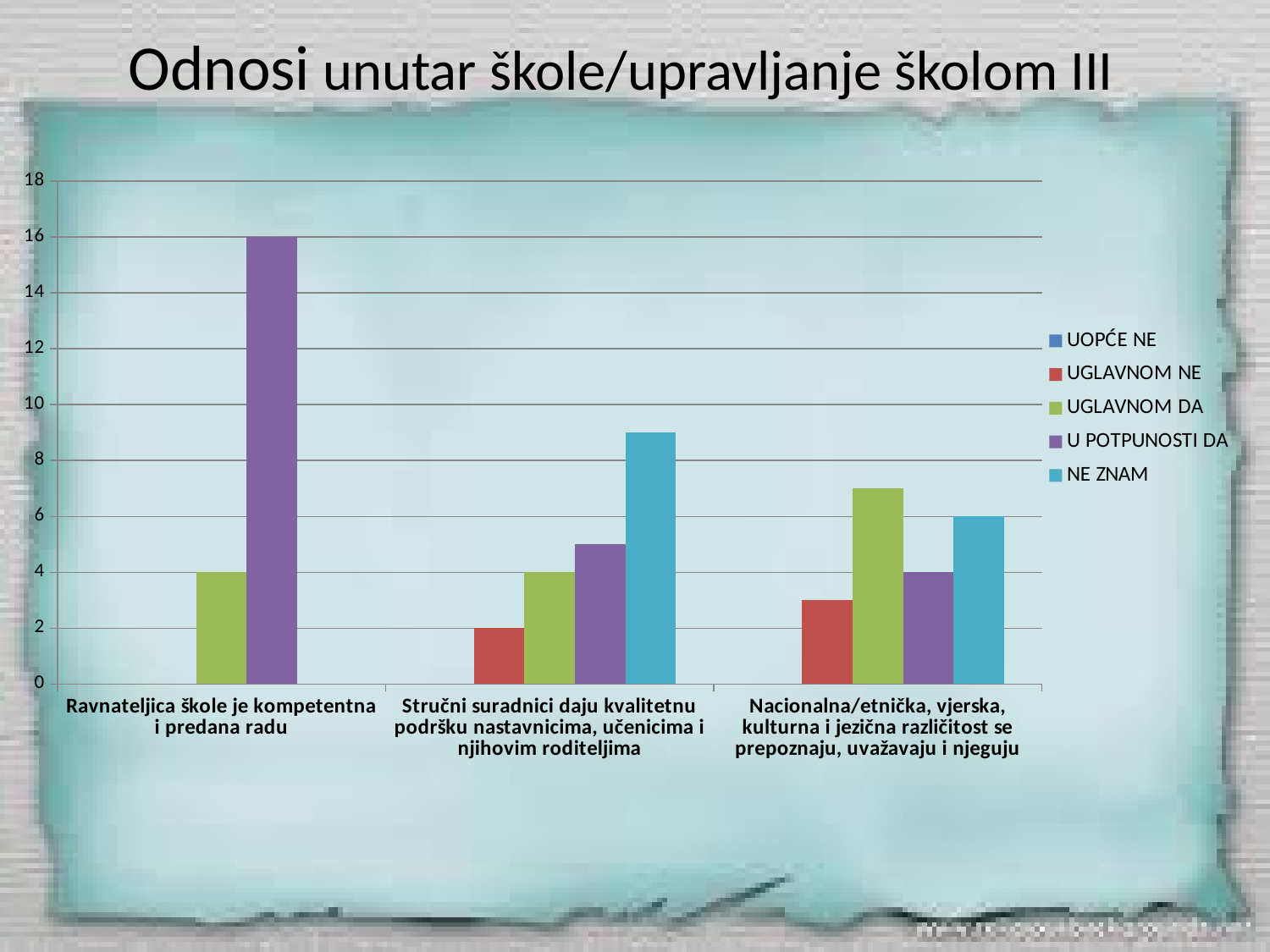
How many series does the legend list? 5 What is the value of U POTPUNOSTI DA for 'Ravnateljica škole je kompetentna i predana radu'? 16 What is the difference between the U POTPUNOSTI DA and UGLAVNOM DA values for 'Ravnateljica škole je kompetentna i predana radu'? 12 Is the value of UGLAVNOM DA for 'Nacionalna/etnička, vjerska, kulturna i jezična različitost se prepoznaju, uvažavaju i njeguju' greater or less than 8? less What is the value of UGLAVNOM NE for 'Stručni suradnici daju kvalitetnu podršku nastavnicima, učenicima i njihovim roditeljima'? 2 Which series has the highest value for 'Stručni suradnici daju kvalitetnu podršku nastavnicima, učenicima i njihovim roditeljima'? NE ZNAM What kind of chart is shown on the slide? bar chart What is the value of NE ZNAM for 'Nacionalna/etnička, vjerska, kulturna i jezična različitost se prepoznaju, uvažavaju i njeguju'? 6 What is the value of UGLAVNOM DA for 'Ravnateljica škole je kompetentna i predana radu'? 4 Which series has the highest value for 'Ravnateljica škole je kompetentna i predana radu'? U POTPUNOSTI DA How many categories are shown on the x axis? 3 Is the value of NE ZNAM for 'Stručni suradnici daju kvalitetnu podršku nastavnicima, učenicima i njihovim roditeljima' greater or less than 8? greater